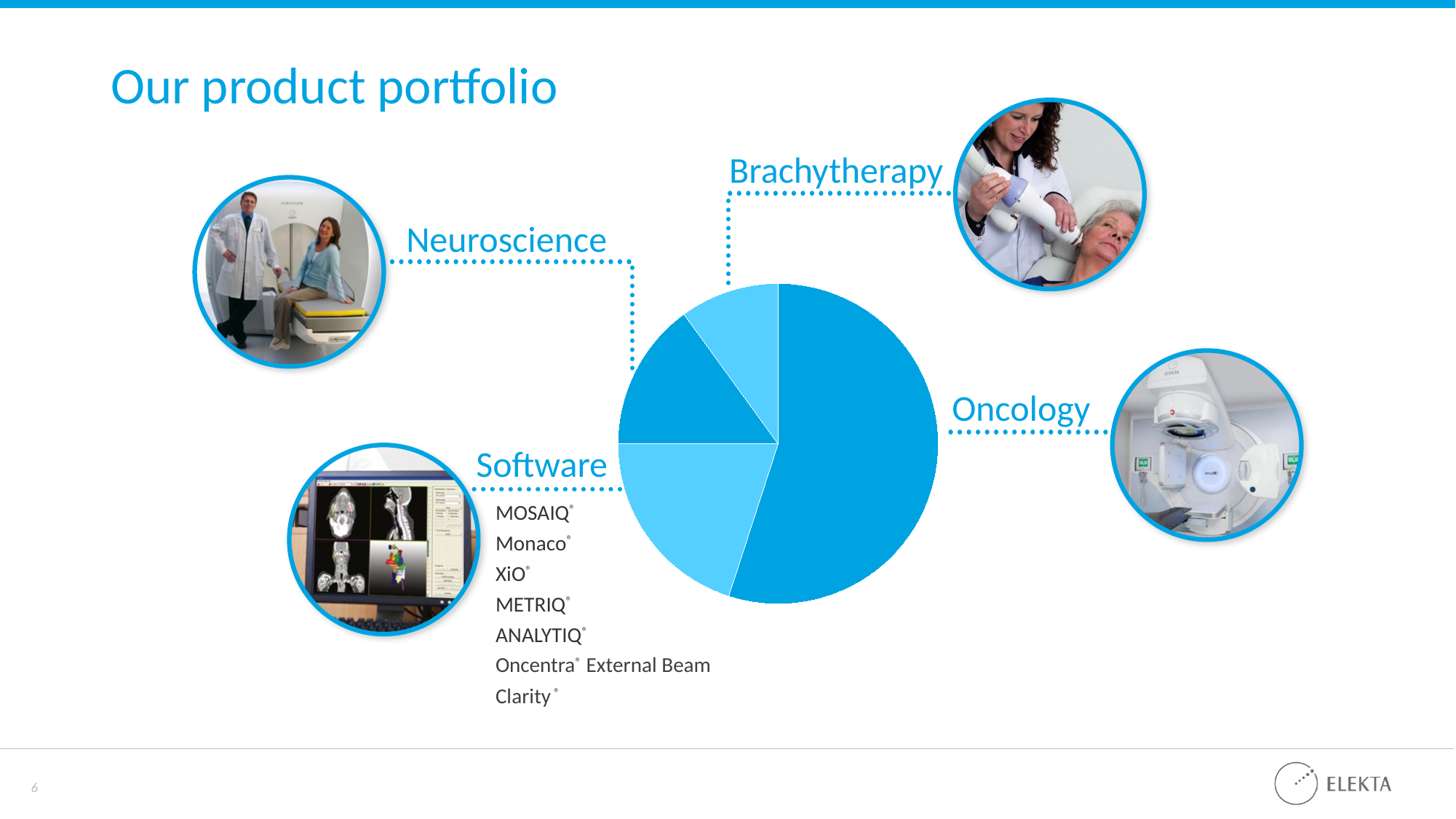
Which slice is larger, Software or Neuroscience? Software How many slices does the pie chart have? 4 What kind of chart is shown on the slide? pie chart Which segment has the largest slice of the pie chart? Oncology Which slice is larger, Oncology or Software? Oncology What is the title of the slide containing the pie chart? Our product portfolio Which segment has the smallest slice of the pie chart? Brachytherapy Which slice is larger, Neuroscience or Brachytherapy? Neuroscience Does the Oncology slice make up more or less than half of the pie? more How many product names are listed under the Software segment? 7